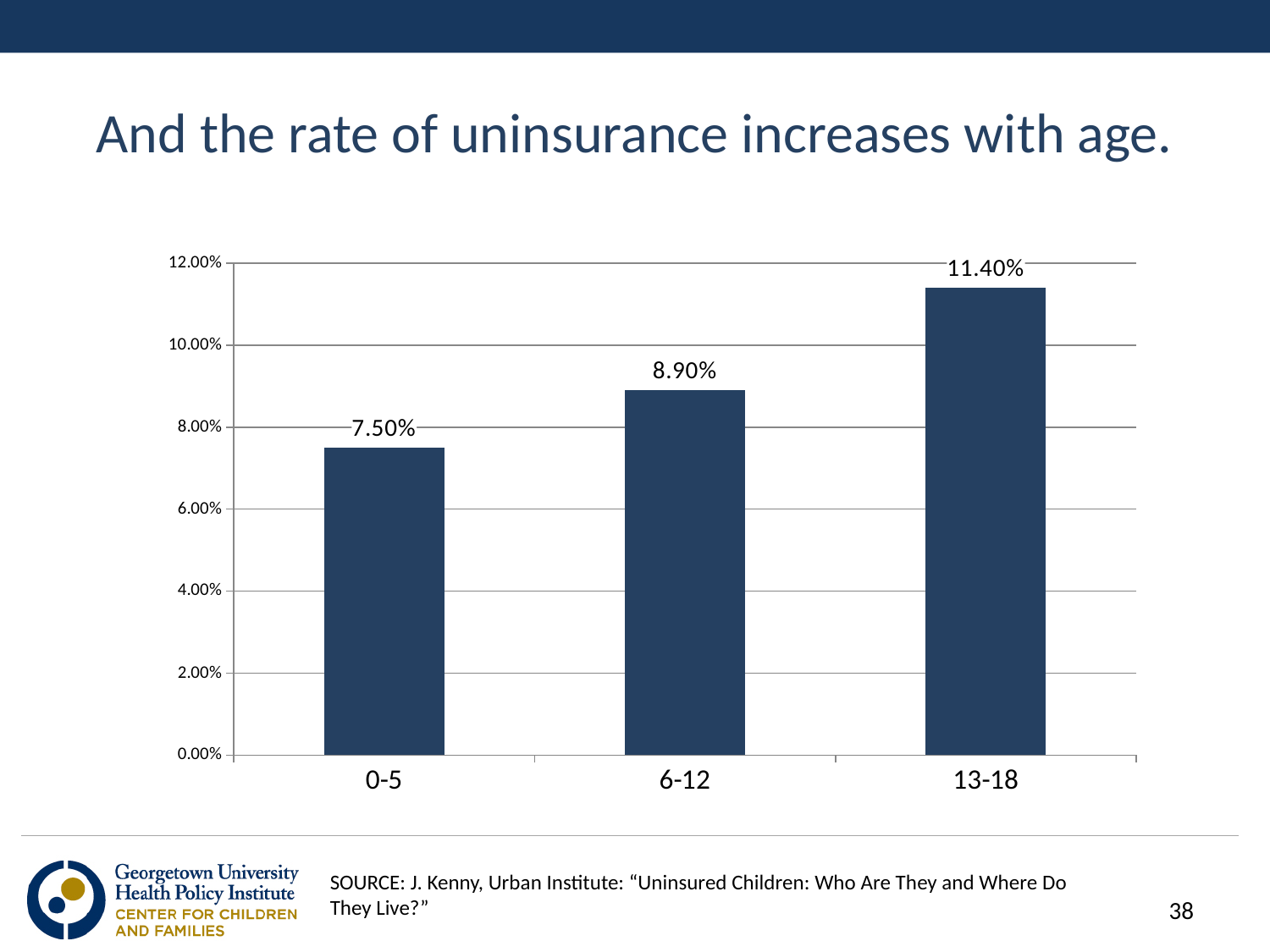
Is the uninsurance rate for the 13-18 age group greater or less than 10.00%? greater Which age group has a higher uninsurance rate, 6-12 or 13-18? 13-18 What is the uninsurance rate for the 13-18 age group? 11.40% Which age group has the highest uninsurance rate? 13-18 What kind of chart is shown on the slide? Bar chart Which age group has the lowest uninsurance rate? 0-5 What is the difference in uninsurance rate between the 13-18 and 0-5 age groups? 3.90% What is the difference in uninsurance rate between the 6-12 and 0-5 age groups? 1.40% How many age groups are shown in the chart? 3 Do the uninsurance rates rise or fall as age group increases along the x axis? Rise What is the uninsurance rate for the 0-5 age group? 7.50% What is the uninsurance rate for the 6-12 age group? 8.90%